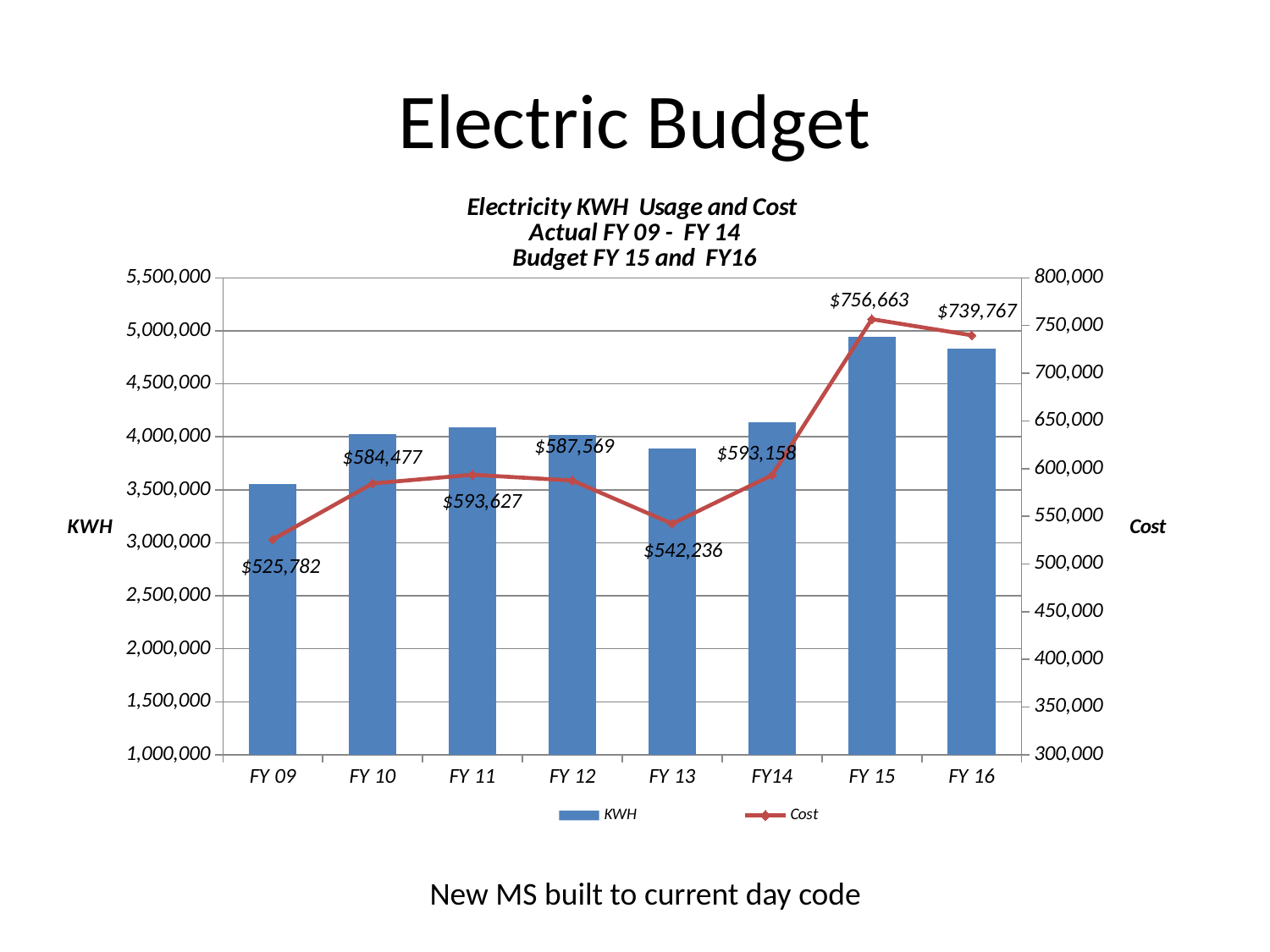
What is the Cost value for FY 09? $525,782 How many fiscal years are shown on the x axis? 8 Which fiscal year has the lowest Cost? FY 09 What is the Cost value for FY 16? $739,767 What is the difference between the Cost for FY 15 and the Cost for FY 16? $16,896 What is the Cost value for FY 13? $542,236 Is the KWH value for FY 09 greater or less than 4,000,000? less Which fiscal year has the highest Cost? FY 15 Is the KWH value for FY 15 greater or less than 4,500,000? greater Which is larger, the Cost for FY 10 or the Cost for FY 13? FY 10 How many series does the legend list? 2 What is the Cost value for FY 15? $756,663